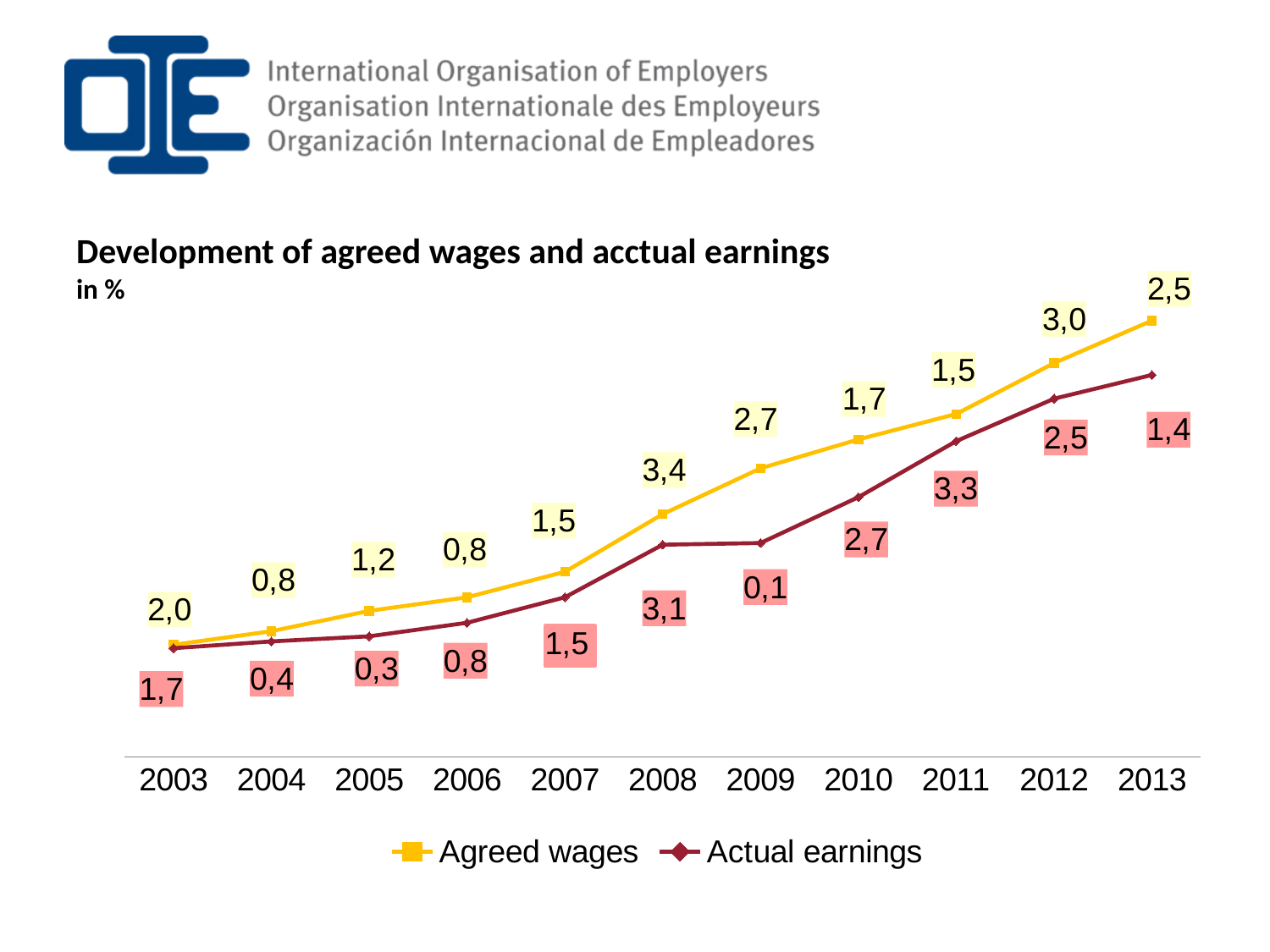
How many series does the legend list? 2 What is the Actual earnings value for 2009? 0,1 What is the Actual earnings value for 2011? 3,3 What unit is stated under the chart title? in % What is the difference between the Agreed wages and Actual earnings values in 2008? 0,3 What is the Agreed wages value for 2008? 3,4 What kind of chart is shown on the slide? Line chart How many years are shown on the x axis? 11 What is the Agreed wages value for 2013? 2,5